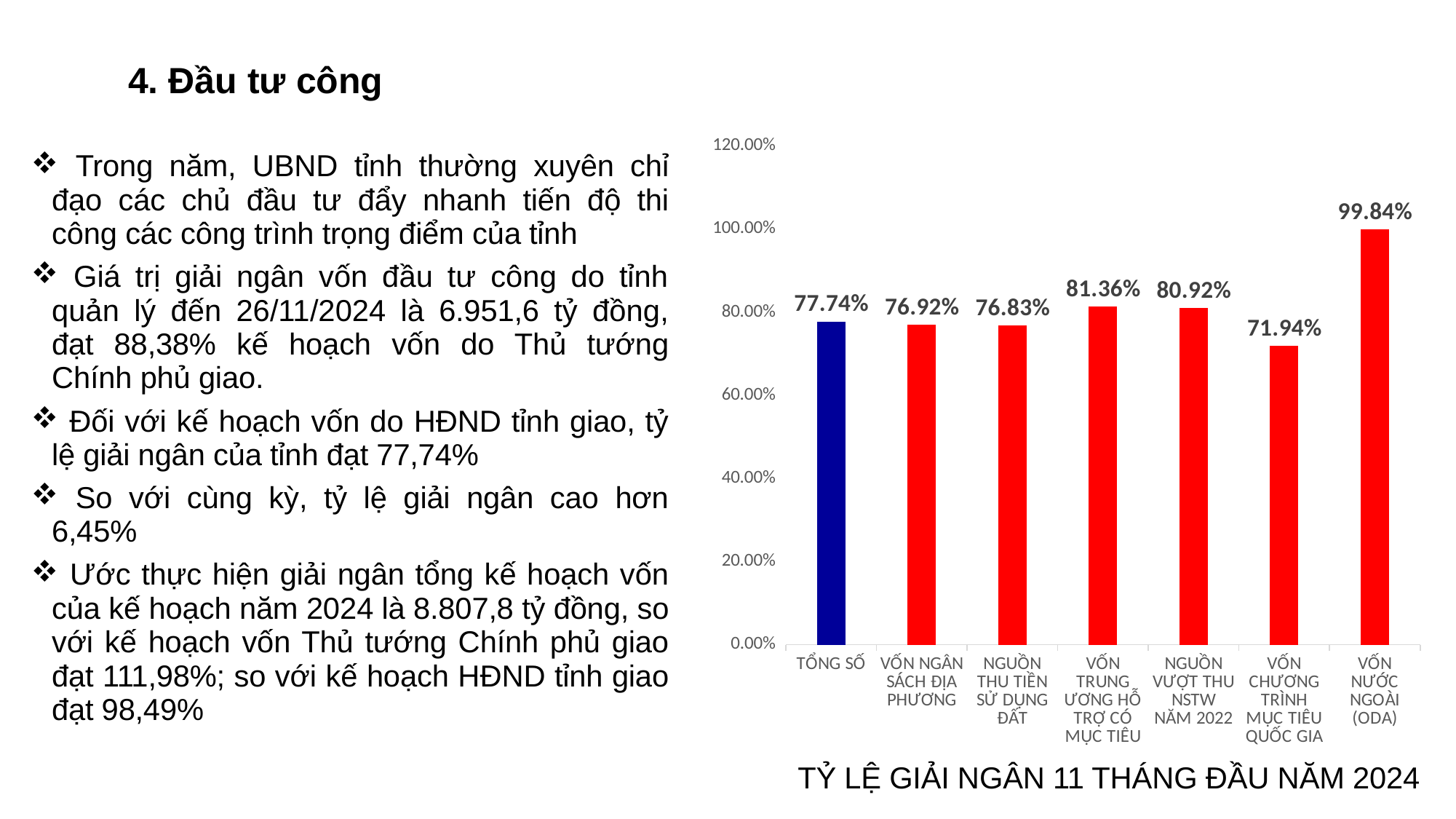
What is the value for TỔNG SỐ? 77.74% What is the value for NGUỒN VƯỢT THU NSTW NĂM 2022? 80.92% What is the value for VỐN CHƯƠNG TRÌNH MỤC TIÊU QUỐC GIA? 71.94% Which category has the lowest value? VỐN CHƯƠNG TRÌNH MỤC TIÊU QUỐC GIA What is the value for VỐN NƯỚC NGOÀI (ODA)? 99.84% Which is larger, the value for VỐN TRUNG ƯƠNG HỖ TRỢ CÓ MỤC TIÊU or the value for VỐN NGÂN SÁCH ĐỊA PHƯƠNG? VỐN TRUNG ƯƠNG HỖ TRỢ CÓ MỤC TIÊU Which category has the highest value? VỐN NƯỚC NGOÀI (ODA) What is the difference between the values for VỐN TRUNG ƯƠNG HỖ TRỢ CÓ MỤC TIÊU and NGUỒN VƯỢT THU NSTW NĂM 2022? 0.44% What is the difference between the values for VỐN NƯỚC NGOÀI (ODA) and VỐN CHƯƠNG TRÌNH MỤC TIÊU QUỐC GIA? 27.90% What is the title of the chart? TỶ LỆ GIẢI NGÂN 11 THÁNG ĐẦU NĂM 2024 What type of chart is shown on the slide? bar chart How many categories are shown on the x axis? 7